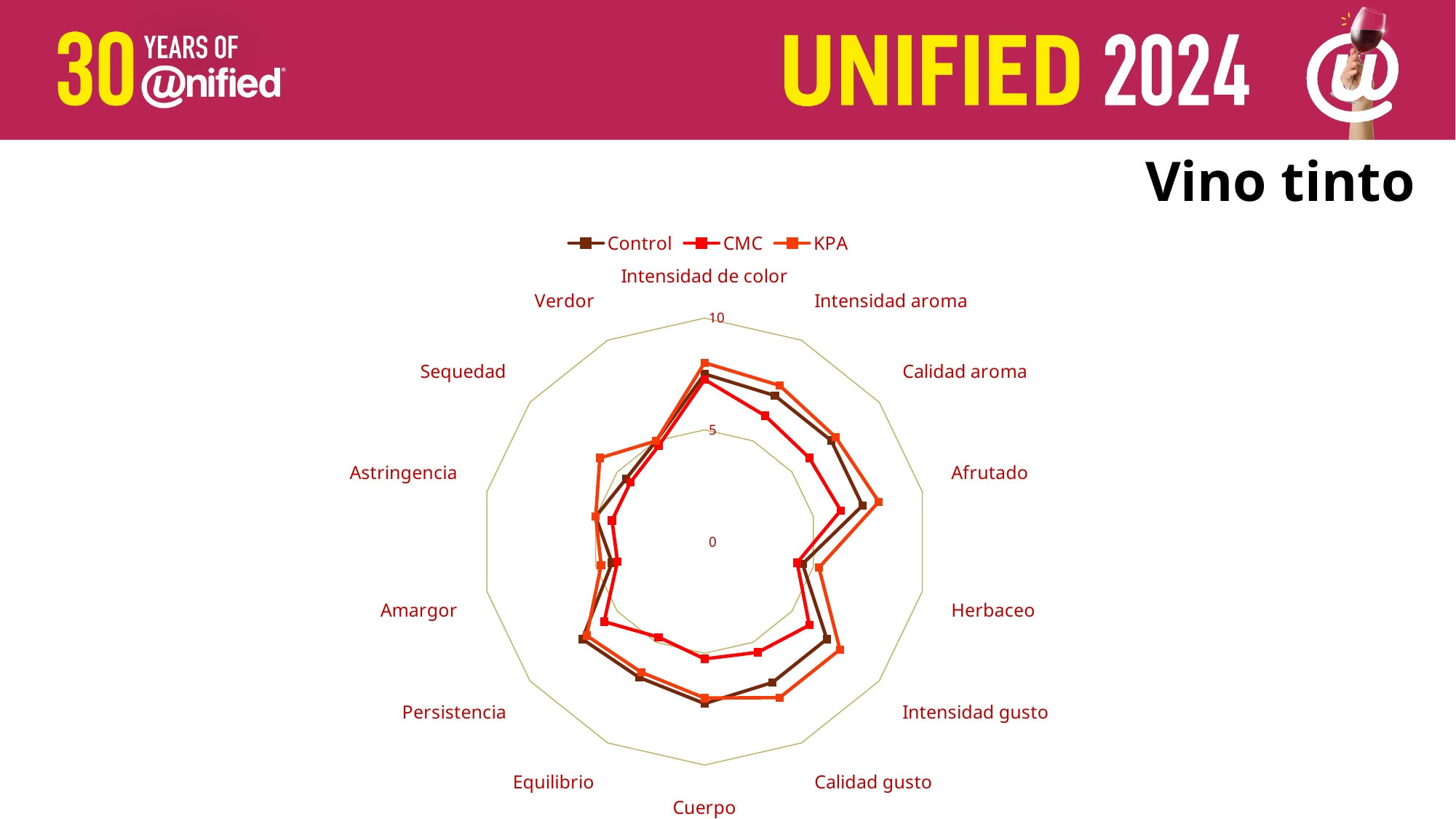
Is the Control value for Cuerpo greater or less than 5? greater For Afrutado, which series has the larger value, KPA or CMC? KPA Is the KPA value for Intensidad de color greater or less than 5? greater How many categories (axes) does the radar chart have? 14 What kind of chart is shown on the slide? radar chart Is the KPA value for Sequedad greater or less than 5? greater What is the maximum value shown on the radar chart's axis scale? 10 For Cuerpo, which series has the larger value, Control or CMC? Control How many series does the legend list? 3 What are the three series named in the legend? Control, CMC, KPA For Intensidad aroma, which series has the larger value, KPA or CMC? KPA